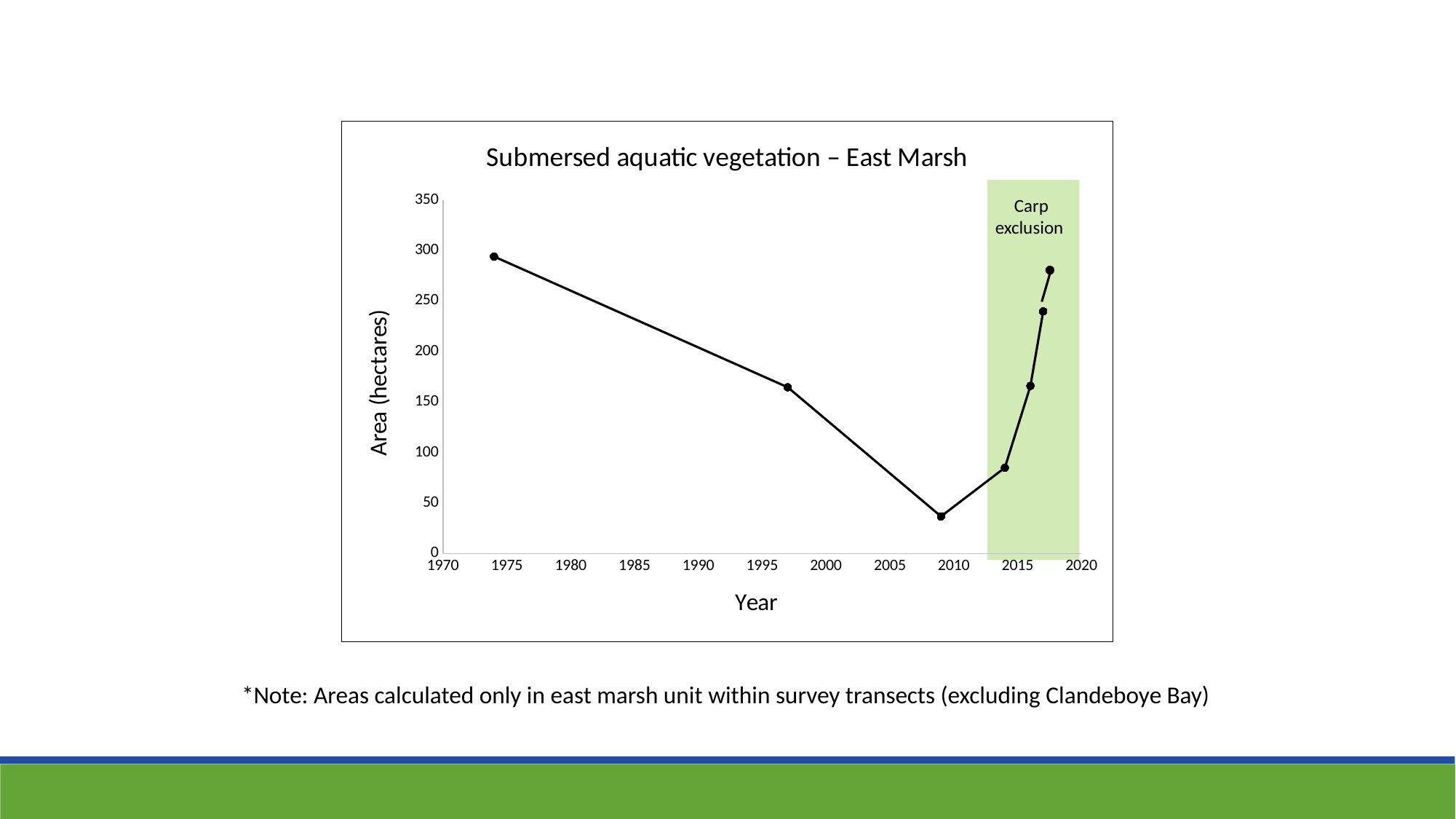
What kind of chart is shown on the slide? line chart Is the value for the data point around 2014 greater or less than 100 hectares? less Do the values rise or fall between 1974 and 2009? fall Is the value for the data point around 2009 greater or less than 50 hectares? less What is the title of the chart? Submersed aquatic vegetation – East Marsh Is the value for the first data point (around 1974) greater or less than 250 hectares? greater Around which year does the line reach its lowest value? 2009 How many data points are plotted on the line? 7 Do the values rise or fall after 2009? rise What label is shown in the green shaded region of the chart? Carp exclusion